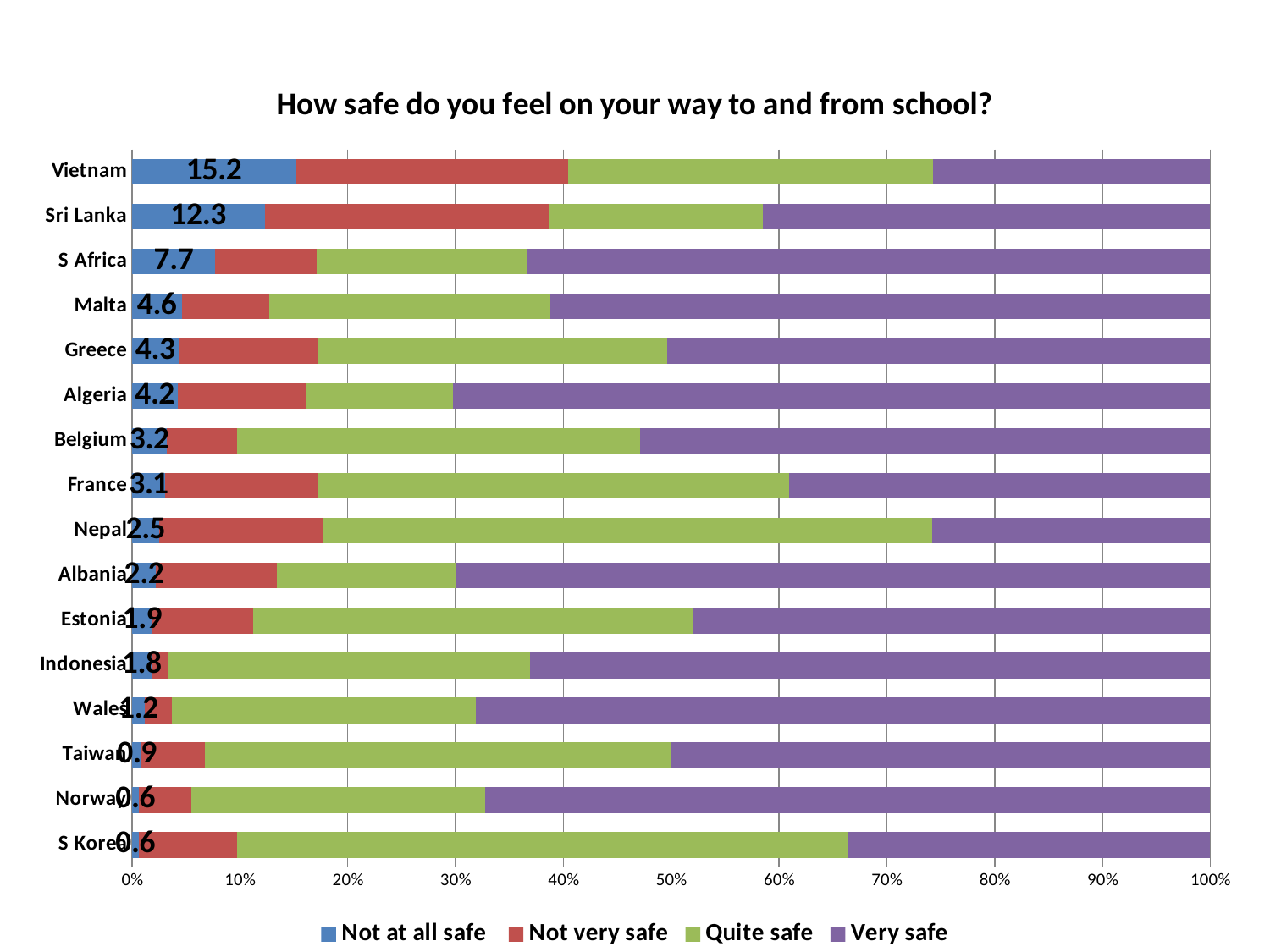
What is the 'Not at all safe' value for Vietnam? 15.2 What kind of chart is shown on the slide? Stacked bar chart Is the 'Very safe' segment for Algeria greater or less than 60%? greater How many countries are shown on the chart? 16 What is the difference between the 'Not at all safe' values for Vietnam and Sri Lanka? 2.9 Which country has the highest 'Not at all safe' value? Vietnam Is the 'Very safe' segment for Nepal greater or less than 30%? less How many series does the legend list? 4 What is the 'Not at all safe' value for Estonia? 1.9 Which has a larger 'Not at all safe' value, Malta or Belgium? Malta What is the 'Not at all safe' value for S Africa? 7.7 What is the title of the chart? How safe do you feel on your way to and from school?